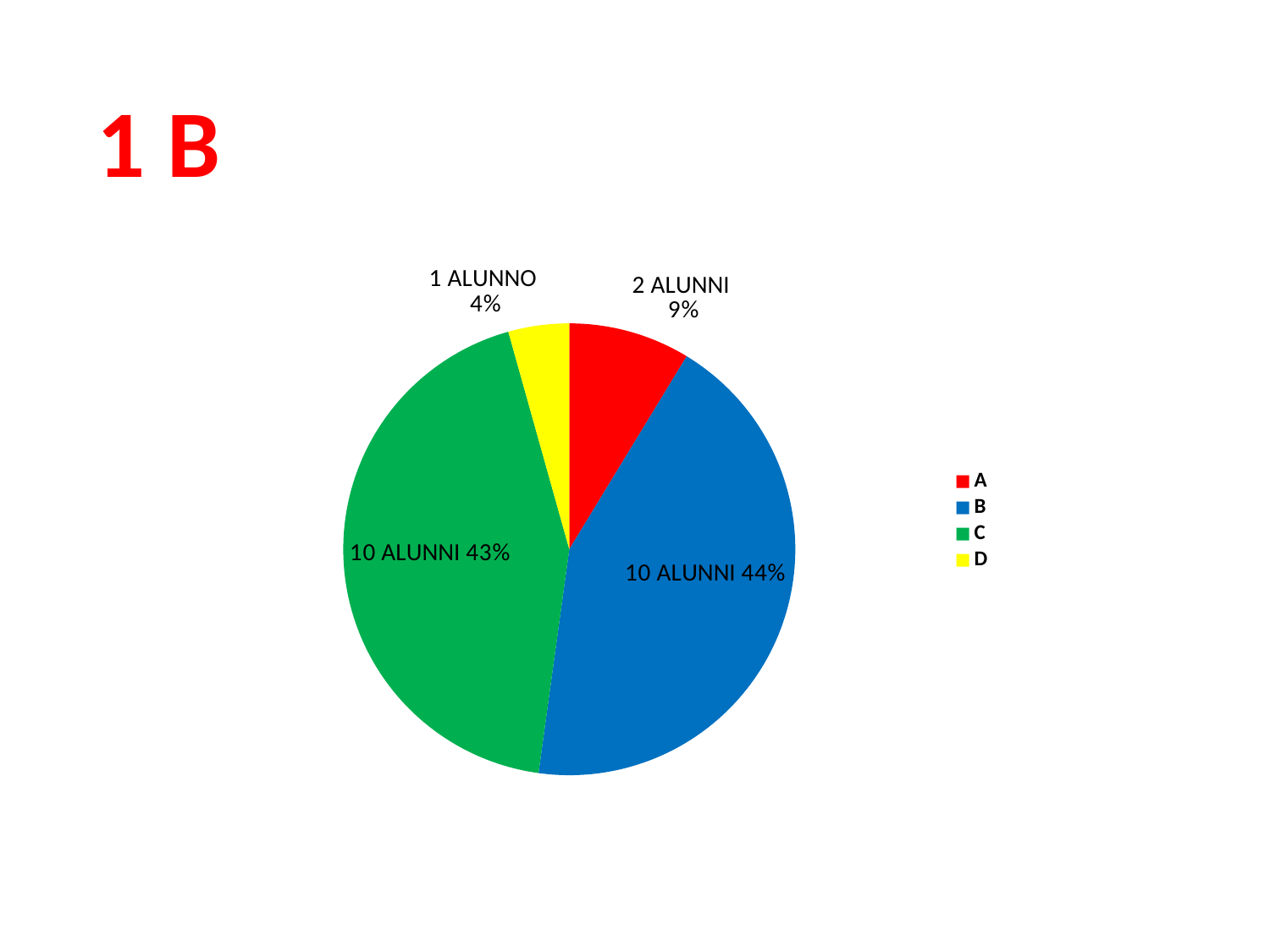
What is the total number of students across all slices? 23 What percentage of the pie does slice A represent? 9% Which slice is larger, A or D? A What kind of chart is shown on the slide? pie chart What colour is slice C in the pie chart? green What is the data label for slice B? 10 ALUNNI 44% How many more students are in slice A than in slice D? 1 What percentage of the pie does slice C represent? 43% Which slice is the smallest? D How many entries does the legend list? 4 What is the data label for slice D? 1 ALUNNO 4% How many slices does the pie chart have? 4